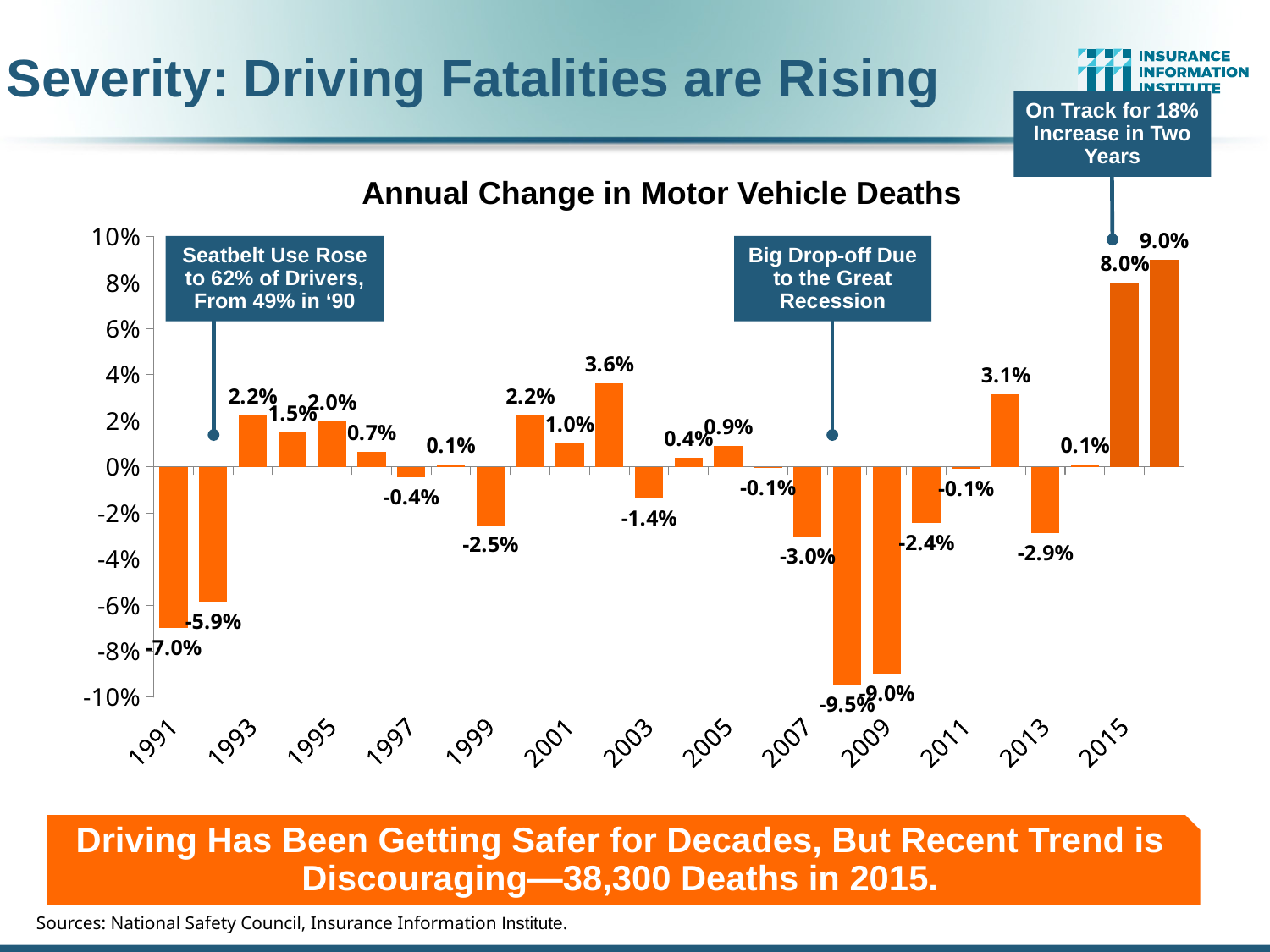
What is the lowest value shown on the chart? -9.5% What is the annual change in motor vehicle deaths for 2015? 8.0% Which year has the larger annual change, 2007 or 2011? 2011 What is the annual change in motor vehicle deaths for 1991? -7.0% What is the annual change in motor vehicle deaths for 2013? -2.9% How many bars are plotted on the chart? 26 What is the title of the chart? Annual Change in Motor Vehicle Deaths What is the annual change in motor vehicle deaths for 2009? -9.0% What is the difference between the values for 2015 and 2013? 10.9 percentage points Is the value for 2015 greater or less than 6%? greater What kind of chart is shown on the slide? bar chart What is the highest value shown on the chart? 9.0%